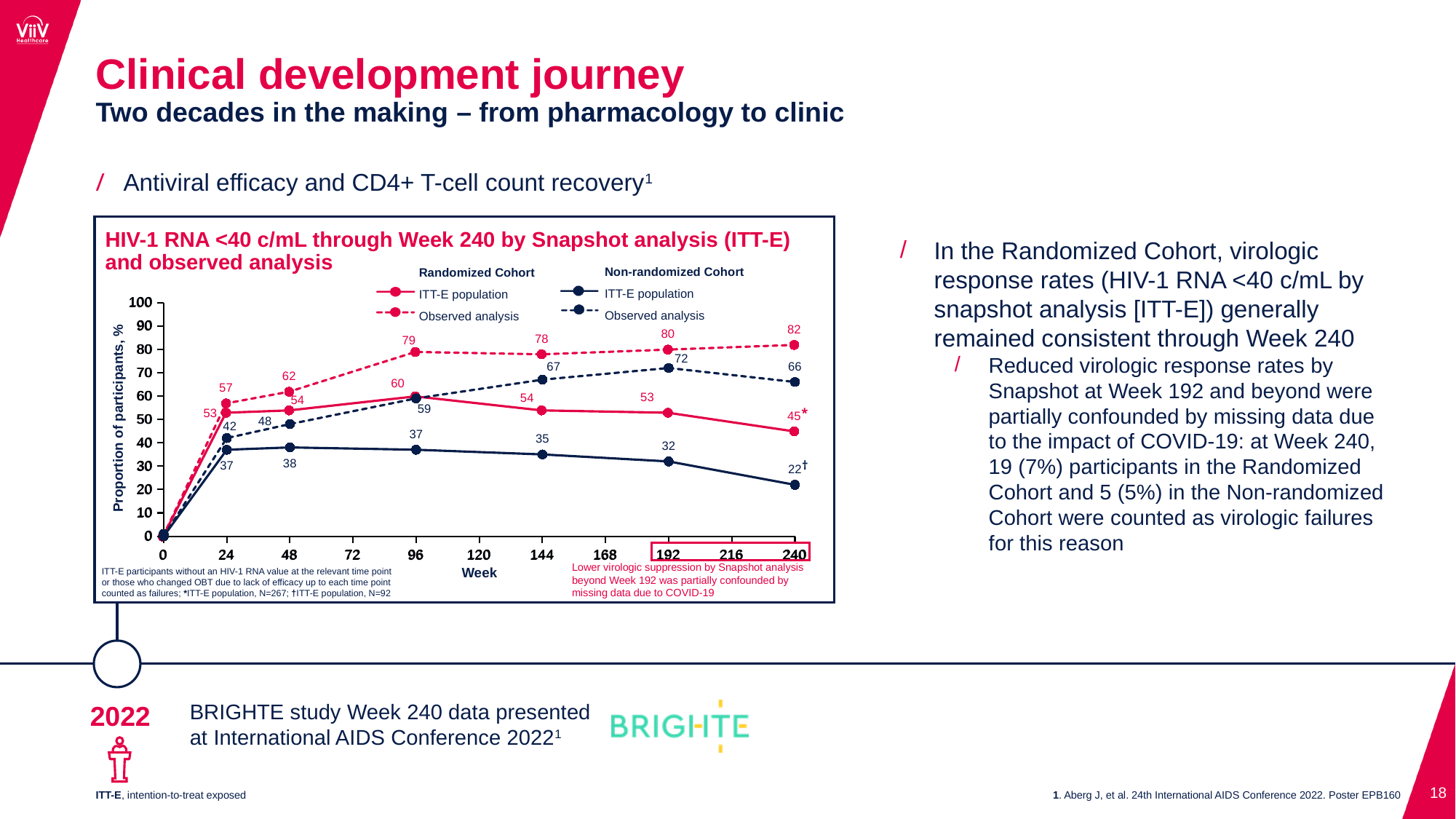
At Week 144, which is larger: the Randomized Cohort ITT-E population or the Non-randomized Cohort Observed analysis? Non-randomized Cohort Observed analysis What is the value for the Non-randomized Cohort Observed analysis at Week 144? 67 What is the value for the Randomized Cohort ITT-E population at Week 96? 60 What kind of chart is shown? Line chart At which week does the Non-randomized Cohort Observed analysis reach its highest value? Week 192 Does the Non-randomized Cohort ITT-E population rise or fall from Week 96 to Week 240? Fall What is the value for the Randomized Cohort Observed analysis at Week 240? 82 How many series does the legend list? 4 For the Non-randomized Cohort Observed analysis, how much does the value drop from Week 192 to Week 240? 6 At Week 240, what is the difference between the Randomized Cohort Observed analysis and the Randomized Cohort ITT-E population? 37 At which week does the Randomized Cohort Observed analysis reach its highest value? Week 240 What is the value for the Non-randomized Cohort ITT-E population at Week 240? 22